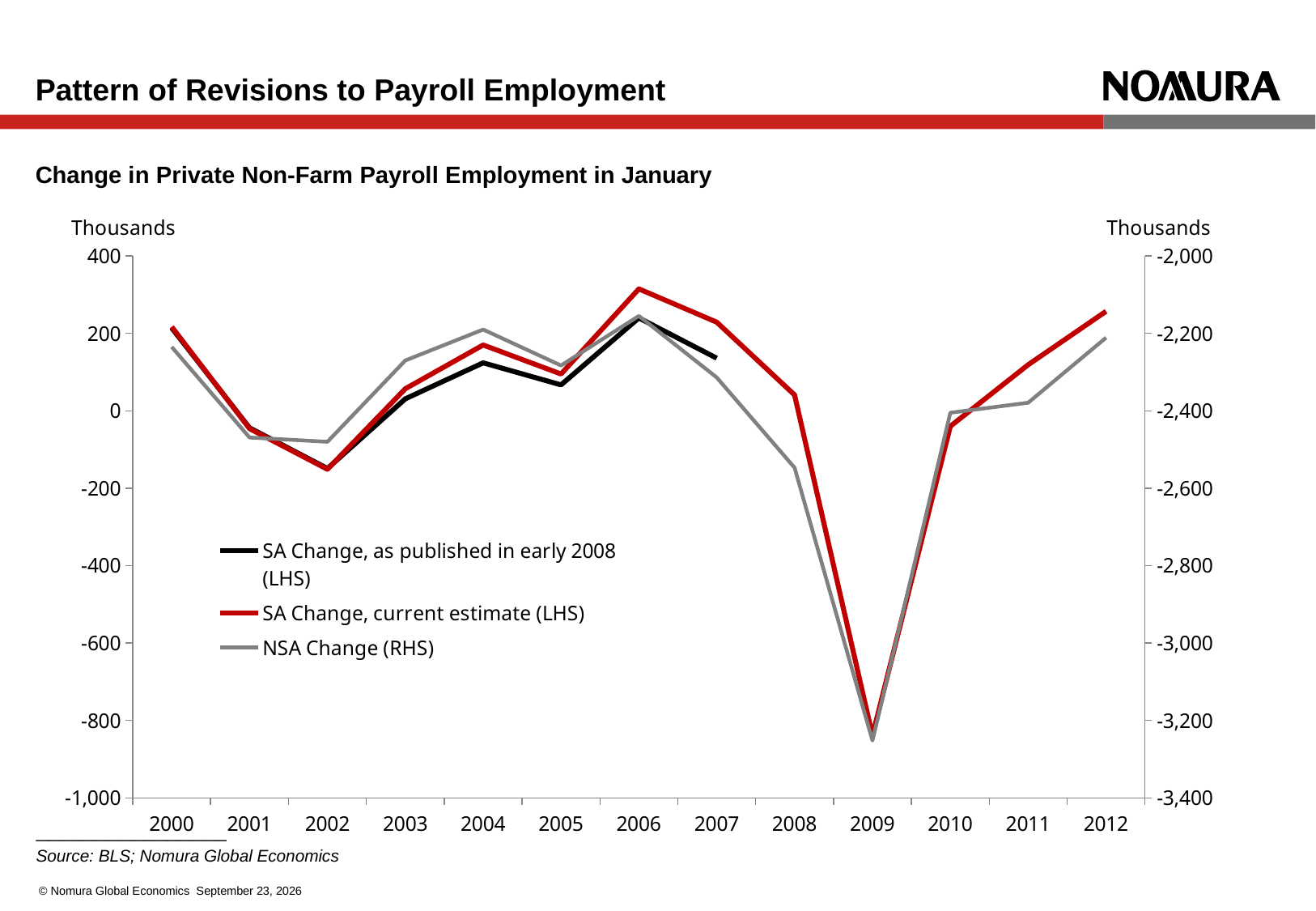
Is the SA Change, current estimate (LHS) value for 2009 greater or less than -600? less In 2006, which is larger: the SA Change, current estimate (LHS) or the SA Change, as published in early 2008 (LHS)? SA Change, current estimate (LHS) How many series does the legend list? 3 Is the SA Change, current estimate (LHS) value for 2002 greater or less than 0? less Is the SA Change, current estimate (LHS) value for 2006 greater or less than 200? greater What is the title of the chart? Change in Private Non-Farm Payroll Employment in January In which year is the SA Change, current estimate (LHS) series at its highest? 2006 What kind of chart is shown on the slide? line chart In which year is the SA Change, current estimate (LHS) series at its lowest? 2009 How many years are labelled on the x axis? 13 Does the SA Change, current estimate (LHS) series rise or fall from 2009 to 2012? rise